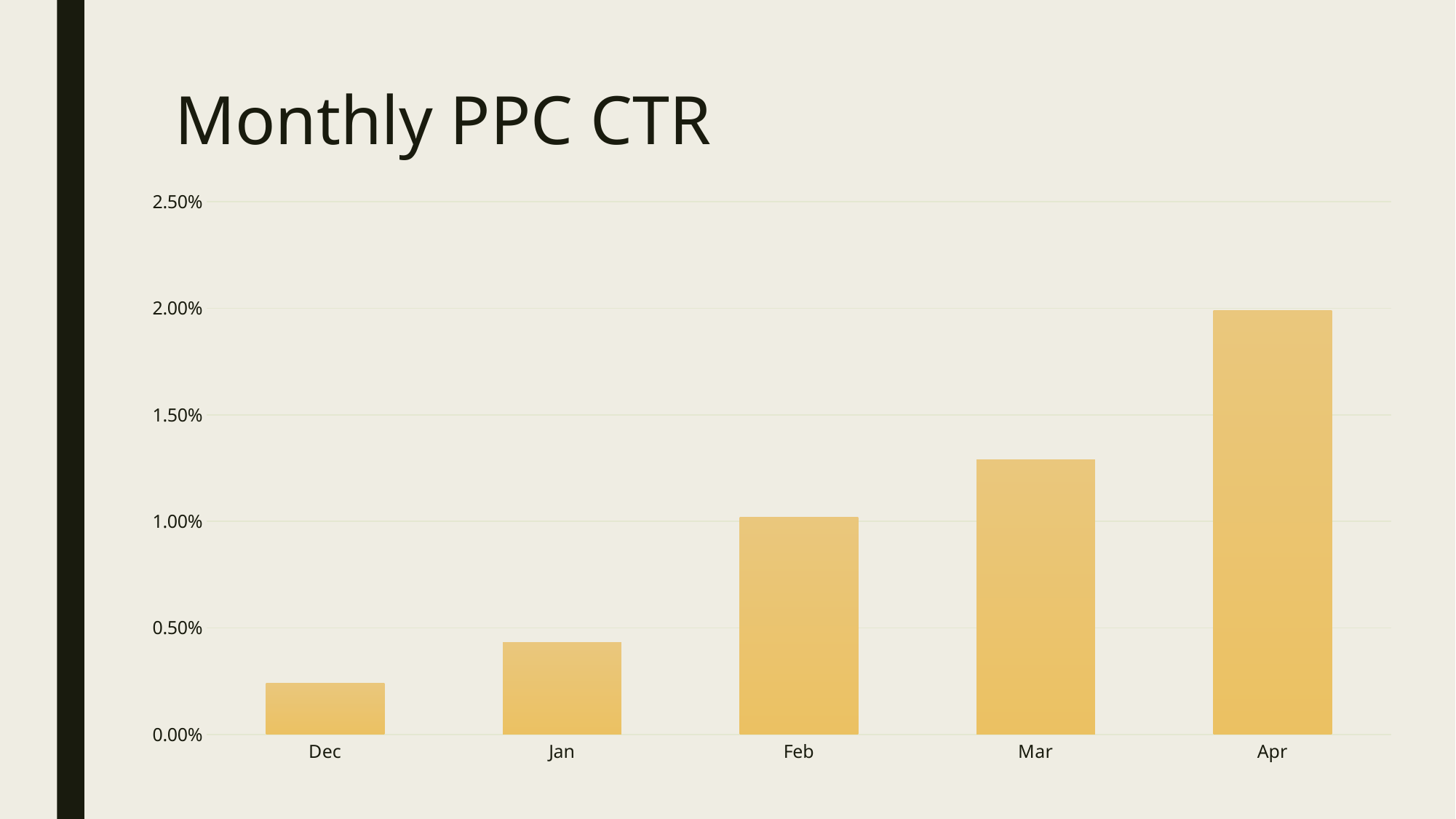
What is the title of the chart? Monthly PPC CTR Which month has the larger CTR, Dec or Jan? Jan Do the CTR values rise or fall from Dec to Apr? rise Is the value for Dec greater or less than 0.50%? less Which month has the lowest CTR? Dec Is the value for Mar greater or less than 1.00%? greater What type of chart is shown on the slide? bar chart How many months are shown on the x axis of the chart? 5 Is the value for Feb greater or less than 1.50%? less Which month has the highest CTR? Apr Which month has the larger CTR, Feb or Mar? Mar